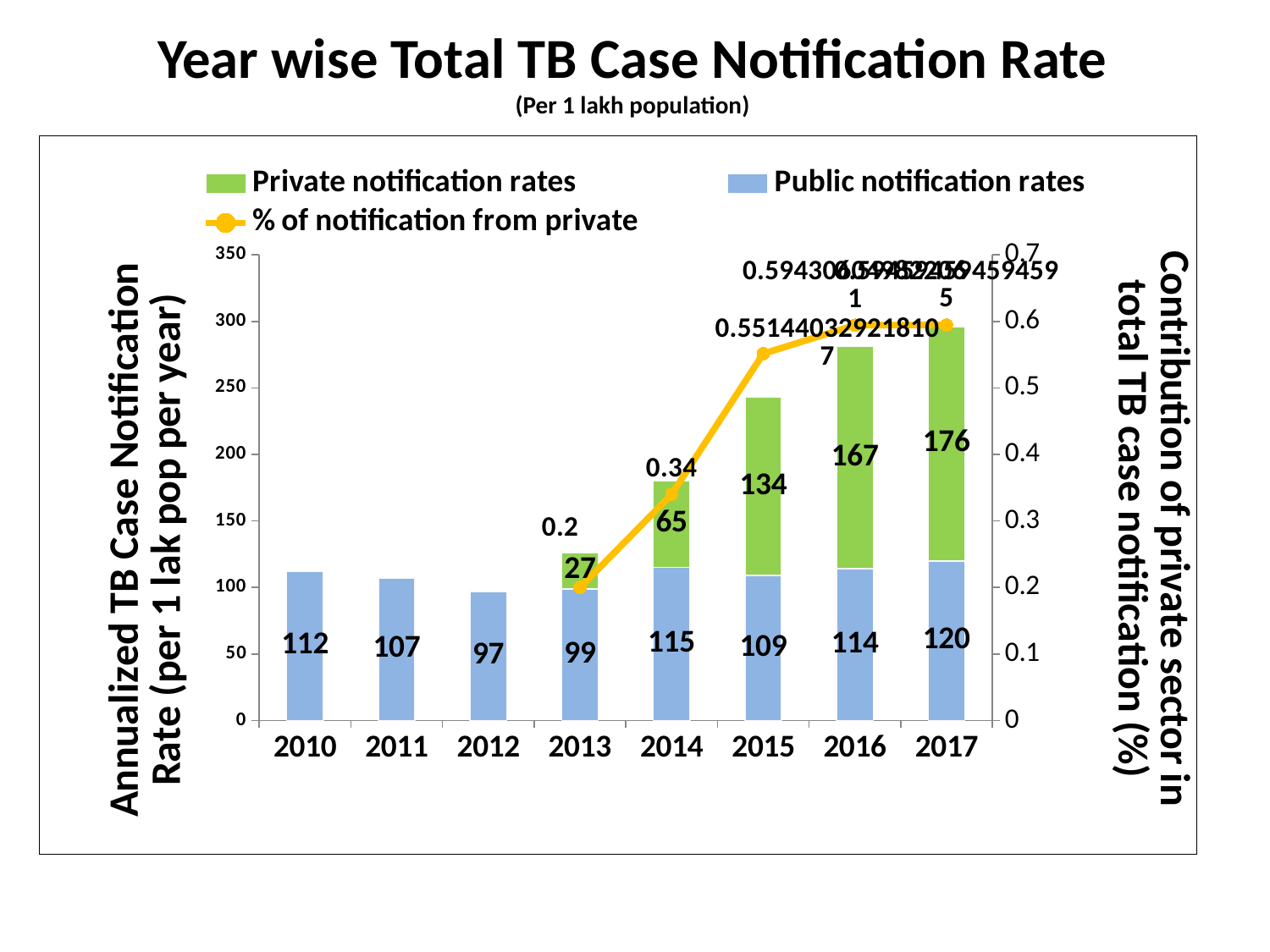
Which year has the highest public notification rate? 2017 What is the difference between the private notification rates for 2017 and 2016? 9 How many years are shown on the x axis? 8 What is the total of the stacked bar for 2017 (public plus private)? 296 What is the total of the stacked bar for 2014 (public plus private)? 180 Which year has the lowest public notification rate? 2012 What is the private notification rate for 2017? 176 Do the private notification rates rise or fall from 2013 to 2017? rise Which is larger, the public notification rate for 2010 or for 2011? 2010 What is the % of notification from private for 2014? 0.34 What is the public notification rate for 2010? 112 How many series does the legend list? 3